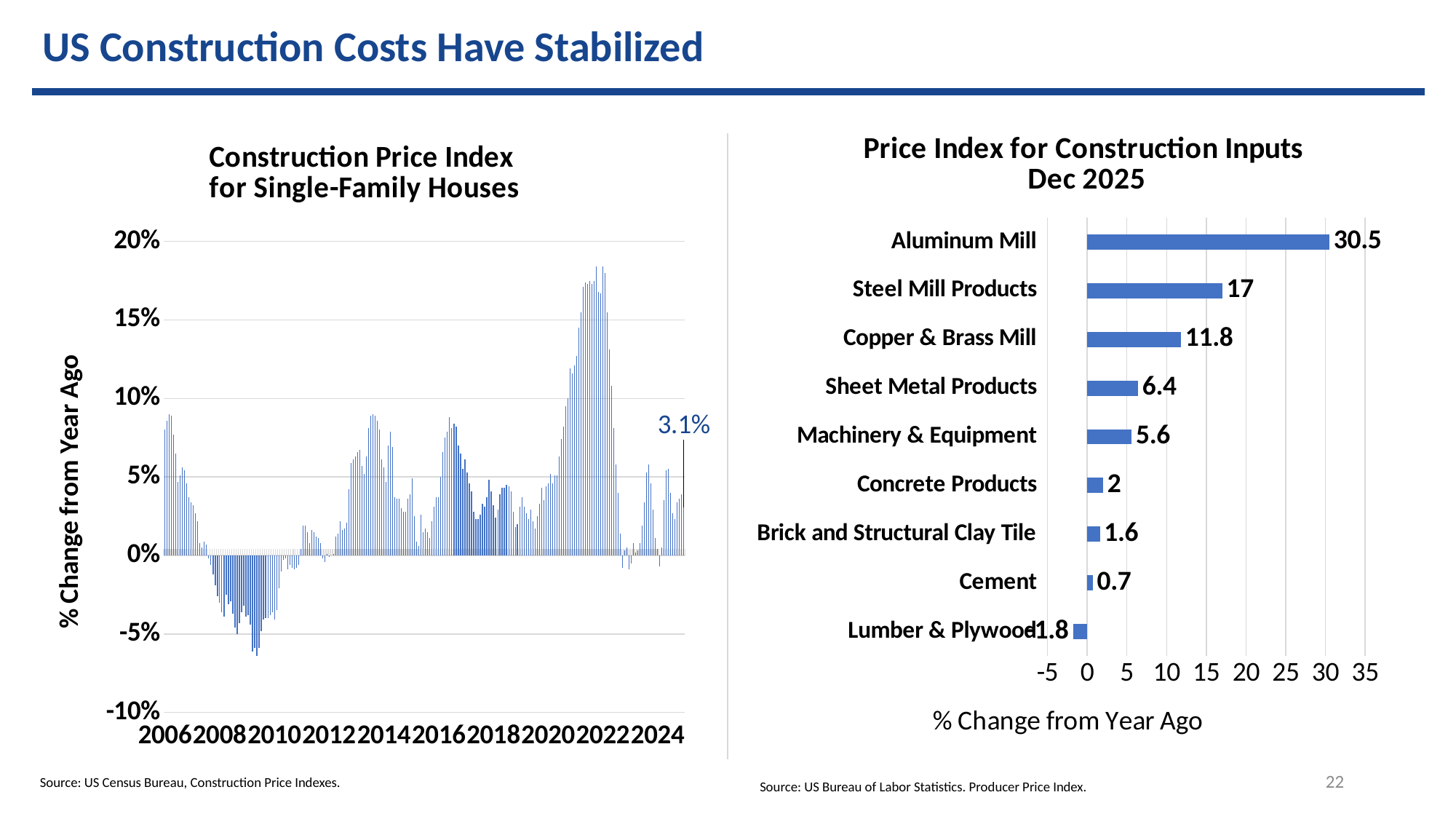
How many categories are shown in the Price Index for Construction Inputs chart? 9 In the Price Index for Construction Inputs chart, which is larger, Sheet Metal Products or Machinery & Equipment? Sheet Metal Products What kind of chart is the Price Index for Construction Inputs chart? bar chart In the Construction Price Index for Single-Family Houses chart, what is the latest value labeled on the chart? 3.1% In the Price Index for Construction Inputs chart, what is the value for Steel Mill Products? 17 In the Price Index for Construction Inputs chart, which category has the highest value? Aluminum Mill In the Price Index for Construction Inputs chart, which category has the lowest value? Lumber & Plywood In the Price Index for Construction Inputs chart, what is the value for Aluminum Mill? 30.5 In the Price Index for Construction Inputs chart, what is the value for Cement? 0.7 In the Price Index for Construction Inputs chart, is the value for Lumber & Plywood greater or less than 0? less In the Price Index for Construction Inputs chart, what is the difference between the values for Aluminum Mill and Steel Mill Products? 13.5 What is the y-axis label of the Construction Price Index for Single-Family Houses chart? % Change from Year Ago